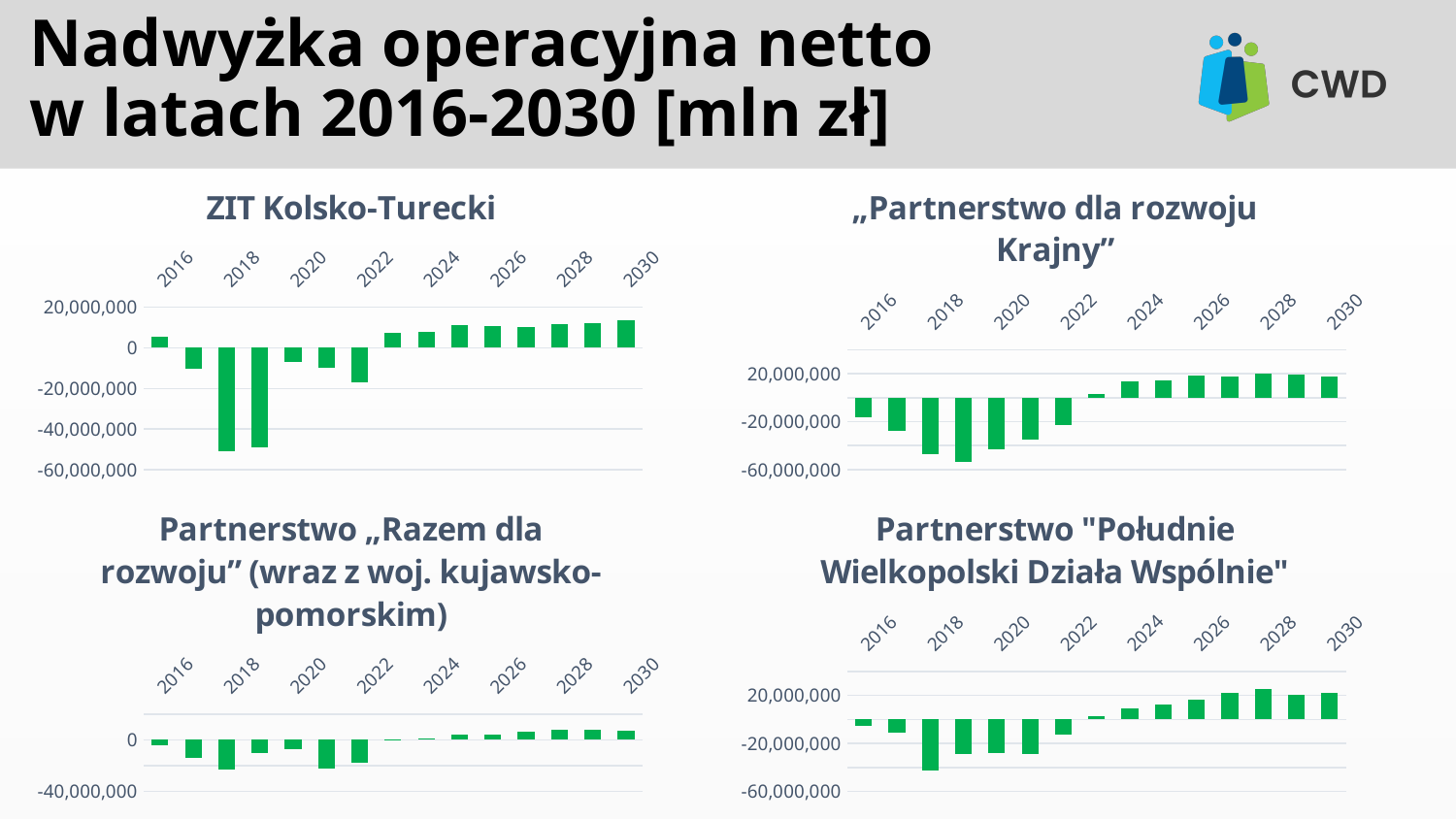
In the "Partnerstwo Południe Wielkopolski Działa Wspólnie" chart, which year has the highest value? 2028 In the "ZIT Kolsko-Turecki" chart, do the values rise or fall from 2023 to 2030? rise In the "Partnerstwo Razem dla rozwoju" chart, is the value for 2018 greater or less than -40,000,000? greater In the "Partnerstwo dla rozwoju Krajny" chart, is the value for 2016 greater or less than -20,000,000? greater How many charts are shown on the slide? 4 In the "ZIT Kolsko-Turecki" chart, is the value for 2018 greater or less than -40,000,000? less What kind of chart is the "ZIT Kolsko-Turecki" chart? bar chart In the "Partnerstwo dla rozwoju Krajny" chart, which year has the lowest value? 2019 In the "Partnerstwo dla rozwoju Krajny" chart, which is larger, the value for 2016 or the value for 2019? 2016 In the "ZIT Kolsko-Turecki" chart, how many years are plotted? 15 In the "Partnerstwo Południe Wielkopolski Działa Wspólnie" chart, which year has the lowest value? 2018